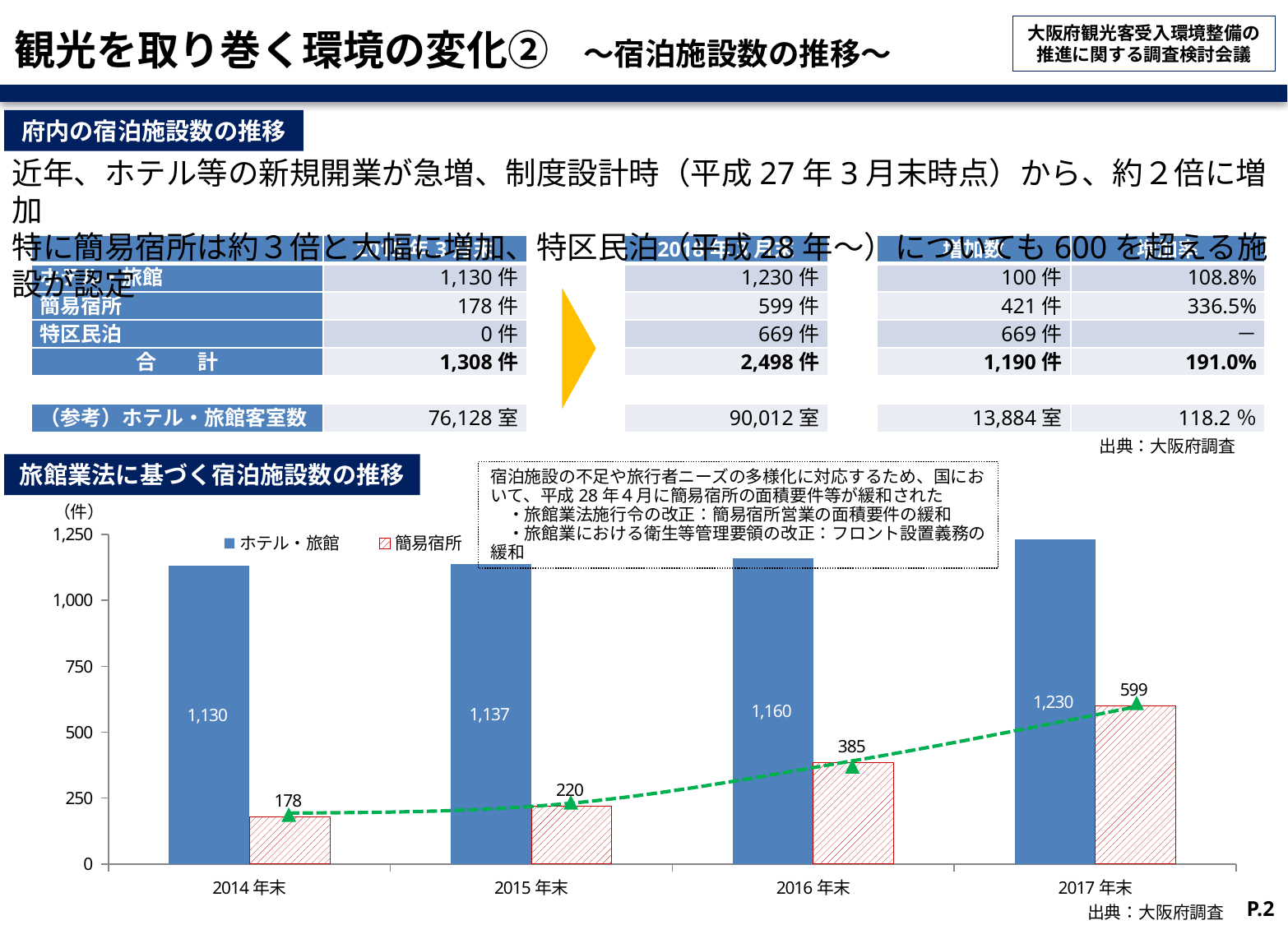
What is the value for 簡易宿所 at 2017年末? 599 What is the value for 簡易宿所 at 2016年末? 385 Which is larger at 2016年末, ホテル・旅館 or 簡易宿所? ホテル・旅館 In which year is the value for 簡易宿所 the highest? 2017年末 How many years are shown on the x axis of the chart? 4 What is the value for ホテル・旅館 at 2014年末? 1,130 What is the value for ホテル・旅館 at 2015年末? 1,137 Do the values for 簡易宿所 rise or fall from 2014年末 to 2017年末? rise What is the difference between the 簡易宿所 values at 2017年末 and 2014年末? 421 In which year is the value for 簡易宿所 the lowest? 2014年末 How many series does the chart legend list? 2 What kind of chart is shown on the slide? bar chart